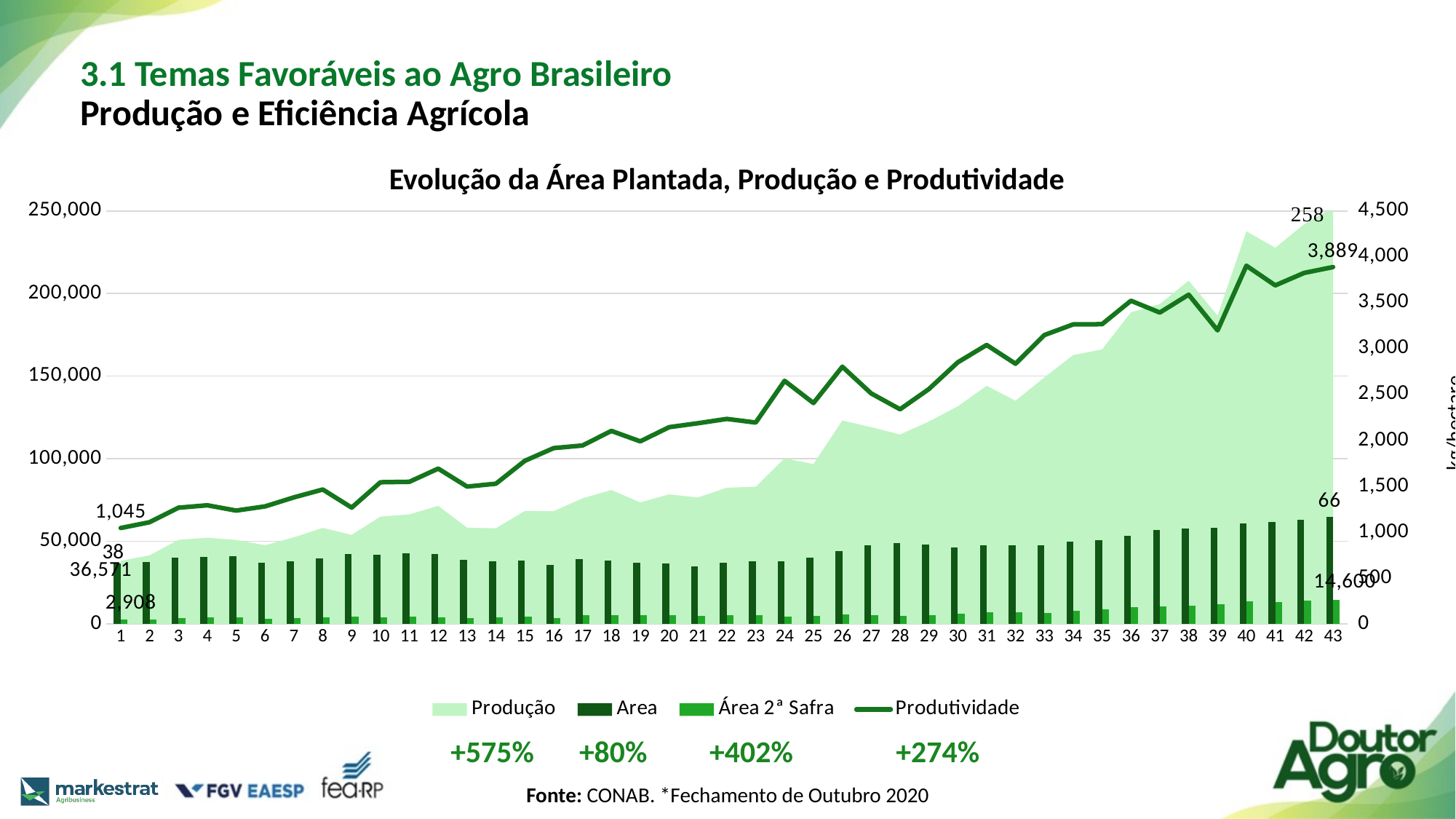
What percentage growth is shown under the Produção legend entry? +575% How many points are shown along the x axis of the chart? 43 How many series does the chart legend list? 4 What is the Área 2ª Safra value labelled at point 43? 14,600 What is the Produtividade value labelled at point 1? 1,045 What is the Area value labelled at point 43? 66 What is the Produtividade value labelled at point 43? 3,889 What is the difference between the Produtividade values labelled at point 43 and point 1? 2,844 What is the title of the chart? Evolução da Área Plantada, Produção e Produtividade Does the Produtividade line generally rise or fall from point 1 to point 43? rise What is the Área 2ª Safra value labelled at point 1? 2,908